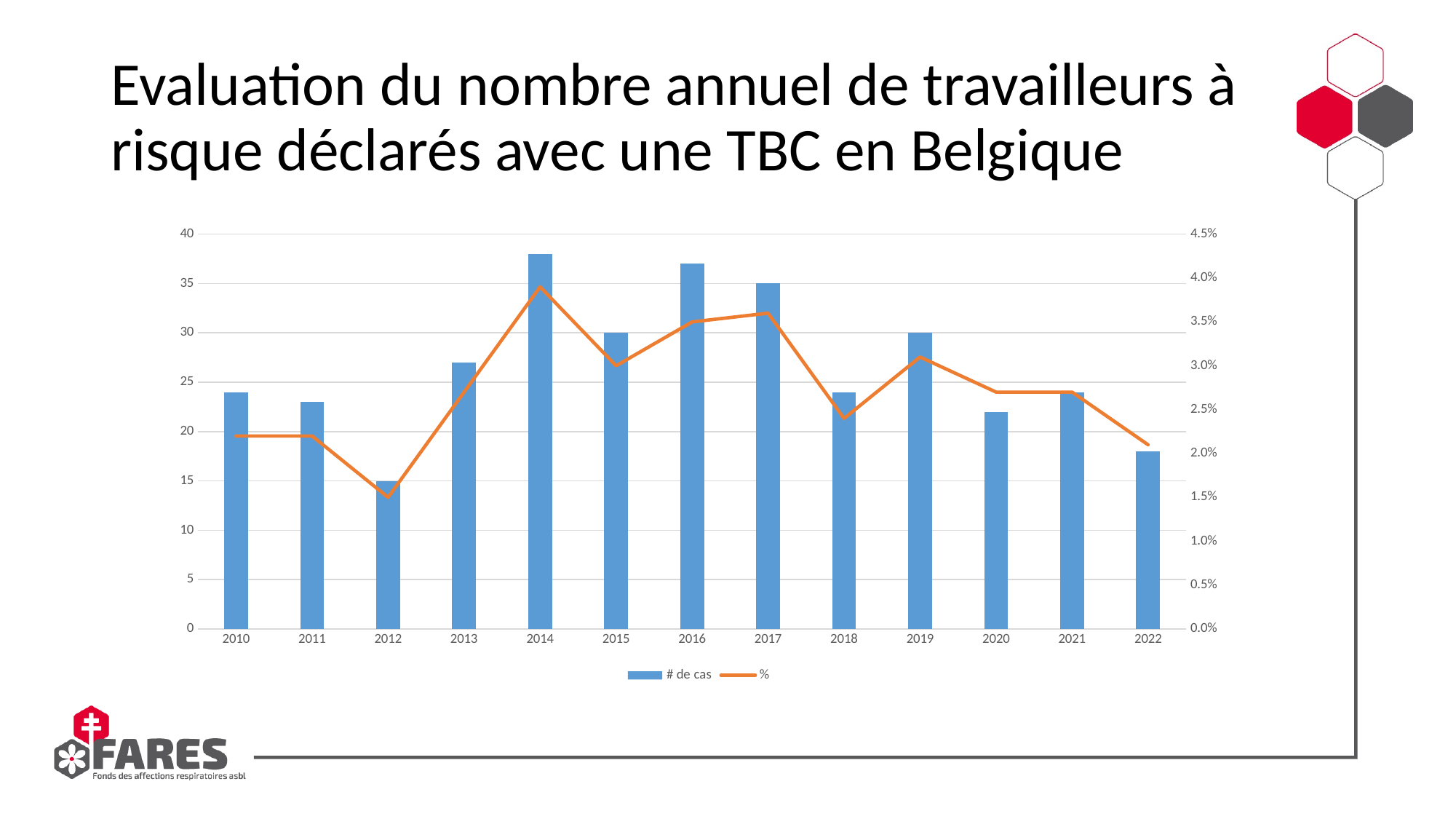
What kind of chart is used for the '# de cas' series? bar chart What is the value of '# de cas' for 2012? 15 How many series does the chart legend list? 2 Is the value of '# de cas' for 2022 greater or less than 20? less What is the value of '# de cas' for 2015? 30 Is the value of '# de cas' for 2014 greater or less than 35? greater Which year has the lowest number of cases (# de cas)? 2012 How many years are shown on the x axis of the chart? 13 Which year has more cases (# de cas), 2016 or 2018? 2016 Is the '%' value for 2014 greater or less than 3.5%? greater Do the '# de cas' bars rise or fall from 2017 to 2018? fall What are the two series named in the chart legend? # de cas and %